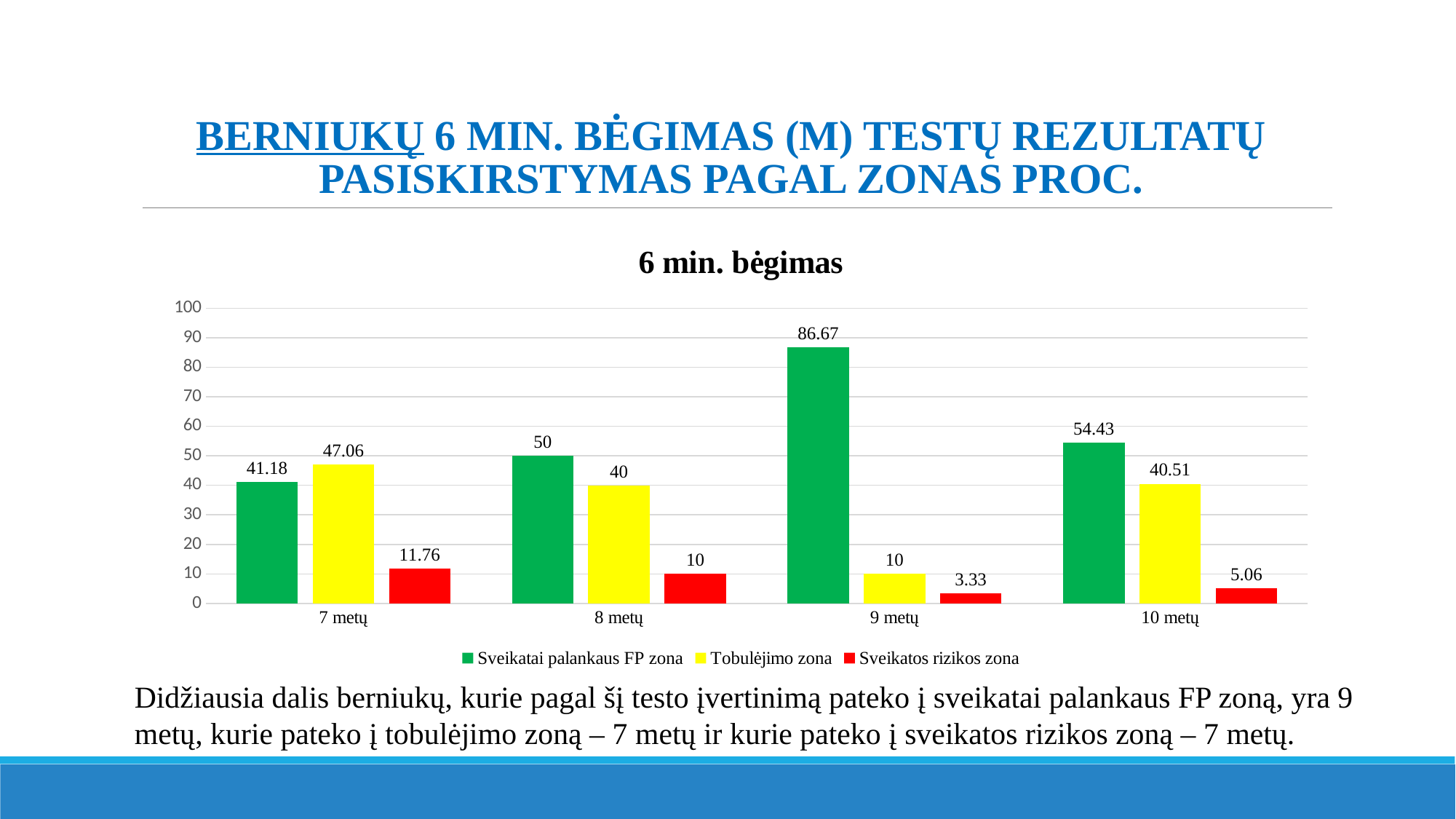
What is the value for Sveikatos rizikos zona for 10 metų? 5.06 What is the value for Tobulėjimo zona for 7 metų? 47.06 What is the difference between the Sveikatai palankaus FP zona values for 9 metų and 10 metų? 32.24 Which age group has the lowest value for Sveikatos rizikos zona? 9 metų What kind of chart is shown? bar chart What is the title of the chart? 6 min. bėgimas What is the value for Sveikatai palankaus FP zona for 9 metų? 86.67 How many age groups are shown on the x axis? 4 Which age group has the highest value for Sveikatai palankaus FP zona? 9 metų Which is larger for 7 metų: Sveikatai palankaus FP zona or Tobulėjimo zona? Tobulėjimo zona Is the value for Sveikatai palankaus FP zona for 8 metų greater or less than 40? greater How many series does the legend list? 3